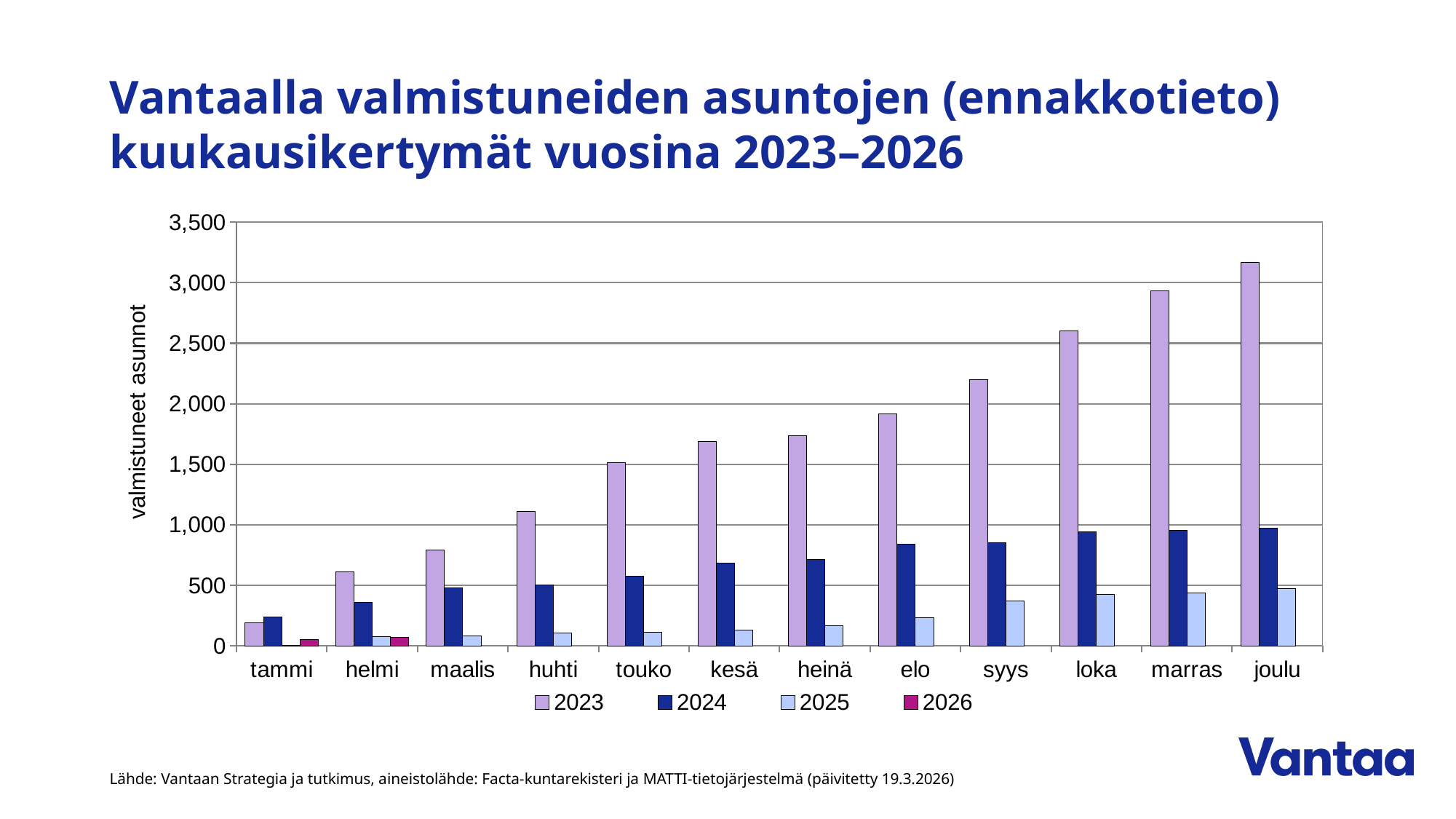
How many months are shown on the x axis? 12 Is the 2023 value for loka greater or less than 2,500? greater Is the 2025 value for syys greater or less than 500? less How many series does the legend list? 4 What is the label on the y axis? valmistuneet asunnot What kind of chart is shown on the slide? bar chart Is the 2023 value for joulu greater or less than 3,000? greater For tammi, which series has the larger value, 2023 or 2024? 2024 Which years are listed in the legend? 2023, 2024, 2025, 2026 Do the 2023 values rise or fall from tammi to joulu? rise In which month is the 2023 series highest? joulu